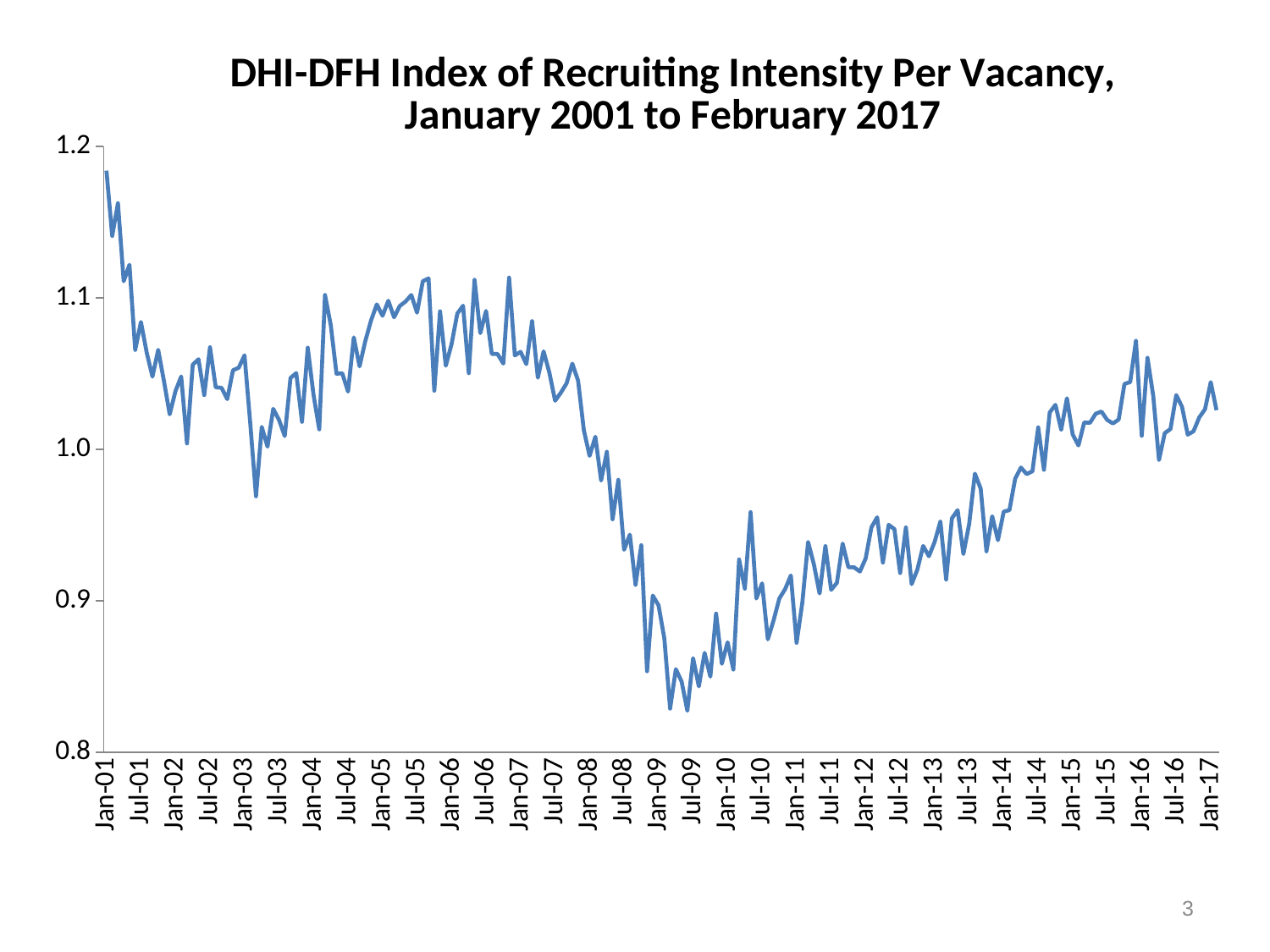
Is the value of the index at Jan-05 greater or less than 1.0? greater Does the index generally rise or fall between Jul-09 and Jan-17? rise Is the value of the index at Jan-14 greater or less than 1.0? less Is the value of the index at Jan-17 greater or less than 1.0? greater Does the index rise or fall between Jan-07 and Jan-09? fall At which x-axis label does the index reach its highest value? Jan-01 What kind of chart is shown on the slide? line chart In which year does the index reach its lowest point? 2009 What is the title of the chart? DHI-DFH Index of Recruiting Intensity Per Vacancy, January 2001 to February 2017